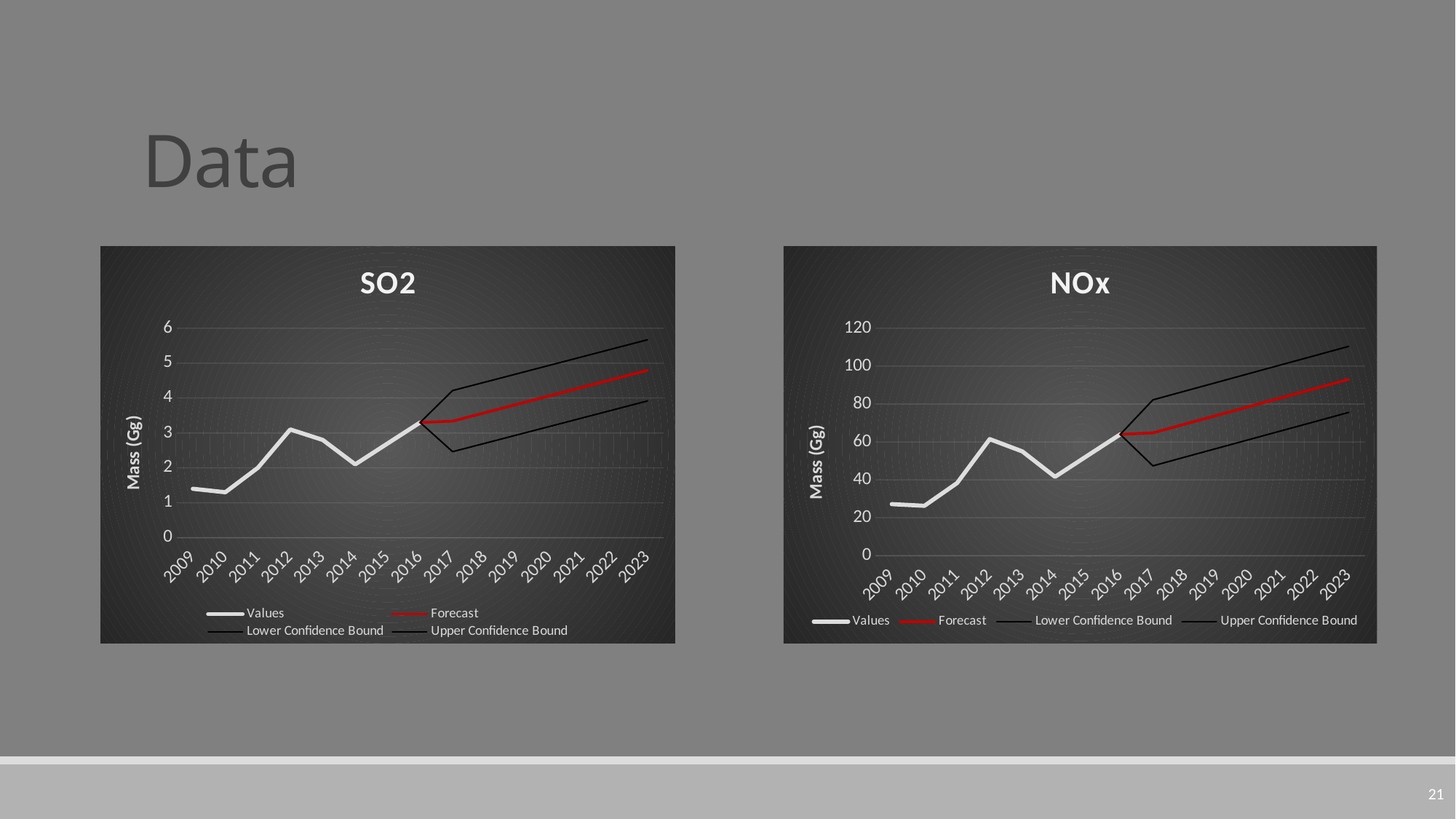
In the SO2 chart, is the Values line for 2009 greater or less than 1? greater In the SO2 chart, in which year does the Upper Confidence Bound reach its highest value? 2023 In the SO2 chart, is the Upper Confidence Bound for 2023 greater or less than 5? greater How many series does the legend of the NOx chart list? 4 What kind of chart is the SO2 chart? line chart What is the y-axis label on the NOx chart? Mass (Gg) In the SO2 chart, is the Values line for 2014 greater or less than 3? less How many years are shown on the x axis of the SO2 chart? 15 In the NOx chart, does the Forecast line rise or fall from 2017 to 2023? rise